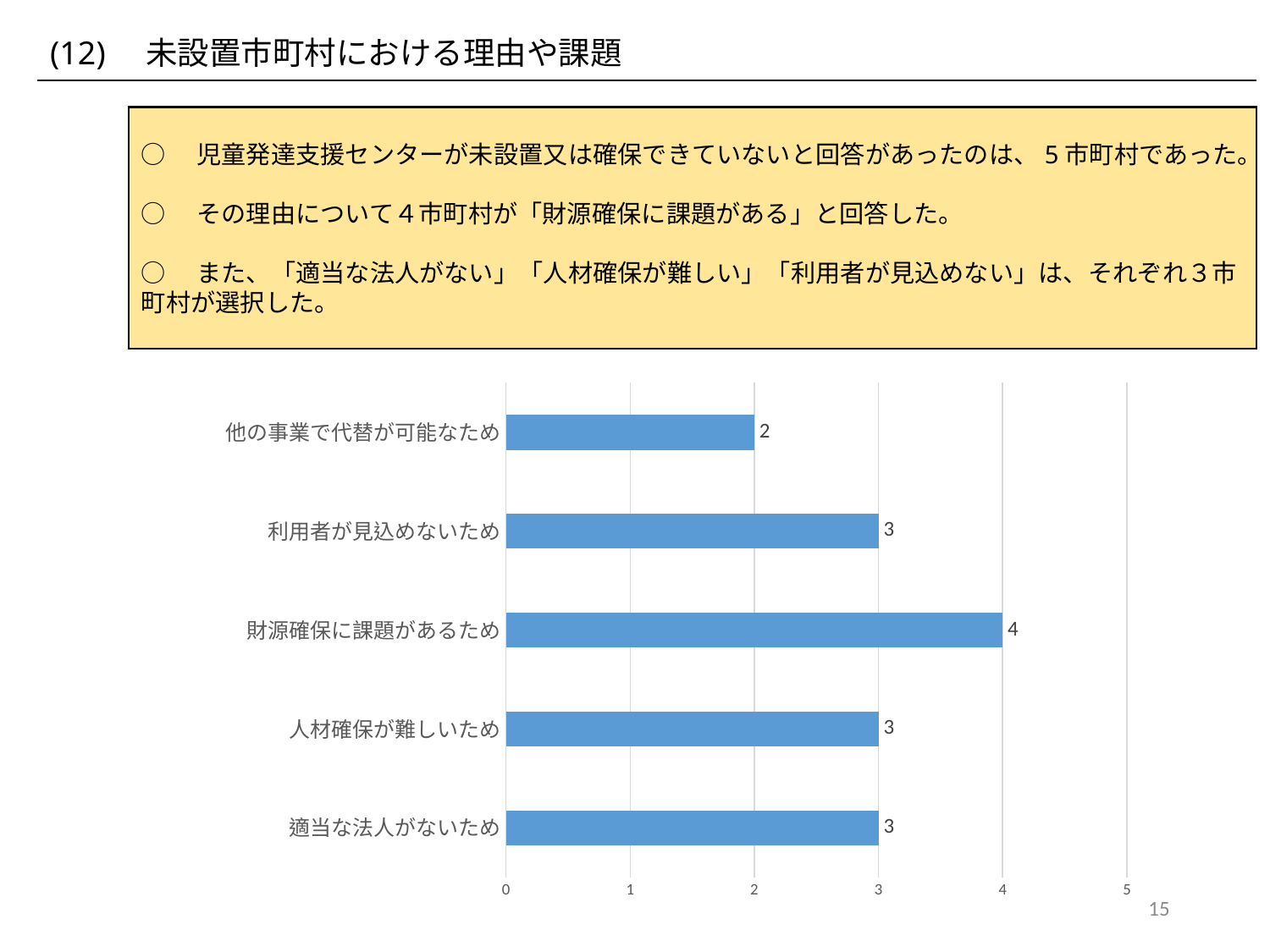
Which category has the highest value? 財源確保に課題があるため What is the value for 財源確保に課題があるため? 4 Which category has the lowest value? 他の事業で代替が可能なため What is the value for 利用者が見込めないため? 3 What is the maximum value shown on the horizontal axis? 5 What is the difference between the values for 財源確保に課題があるため and 他の事業で代替が可能なため? 2 What is the value for 適当な法人がないため? 3 Is the value for 財源確保に課題があるため greater or less than 3? greater Which is larger, the value for 人材確保が難しいため or the value for 他の事業で代替が可能なため? 人材確保が難しいため What kind of chart is shown on the slide? bar chart How many categories are shown in the chart? 5 What is the value for 他の事業で代替が可能なため? 2